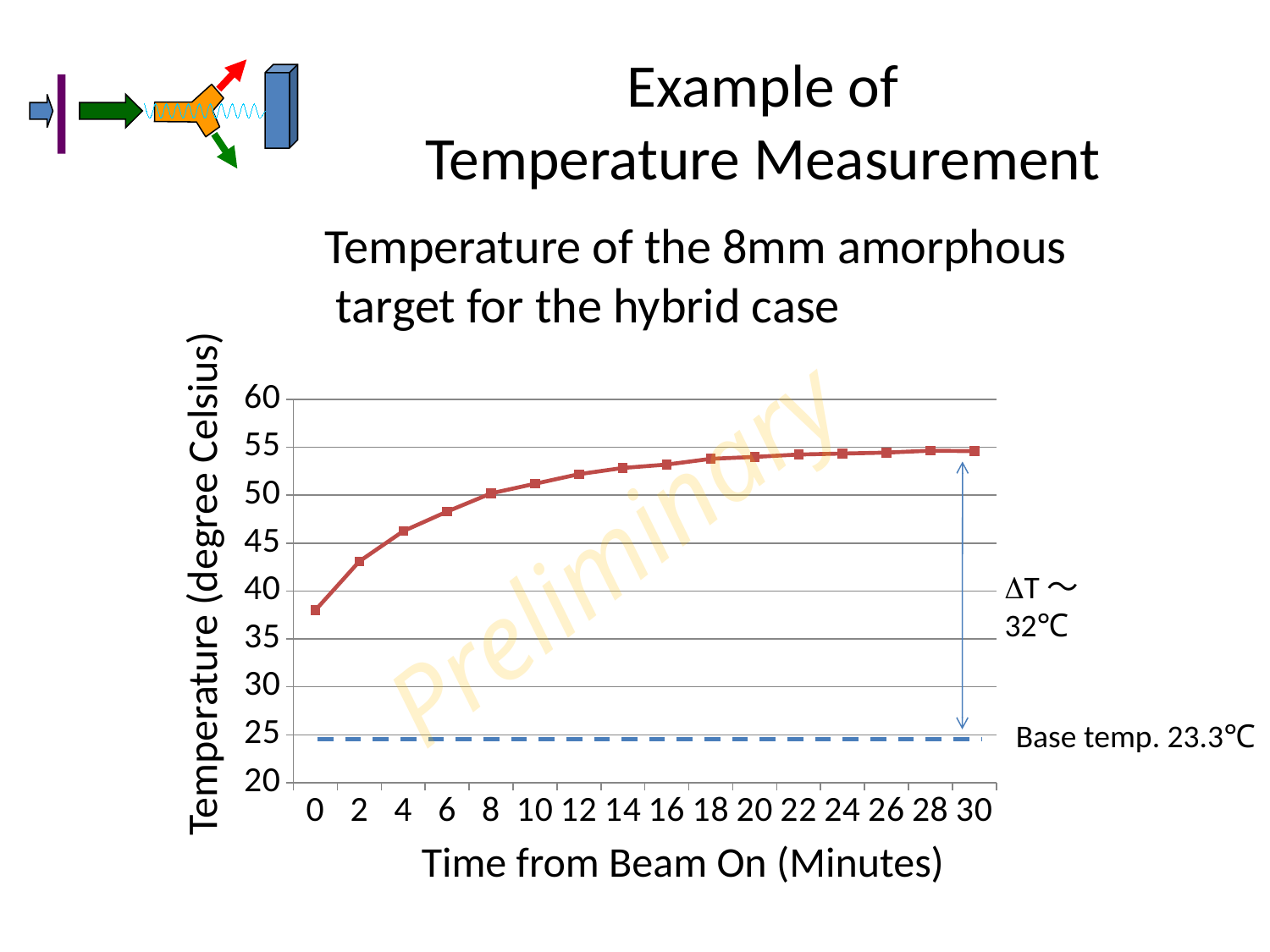
How many data points are plotted on the temperature curve? 16 Which is larger, the temperature at 4 minutes or at 12 minutes? 12 minutes What kind of chart is shown on the slide? line chart Is the temperature at 6 minutes greater or less than 50? less Is the temperature at 2 minutes greater or less than 45? less Is the temperature at 14 minutes greater or less than 50? greater What is the title of the chart? Temperature of the 8mm amorphous target for the hybrid case At which time is the temperature lowest? 0 Does the temperature rise or fall as time from beam on increases? rise What is the label of the x axis? Time from Beam On (Minutes)